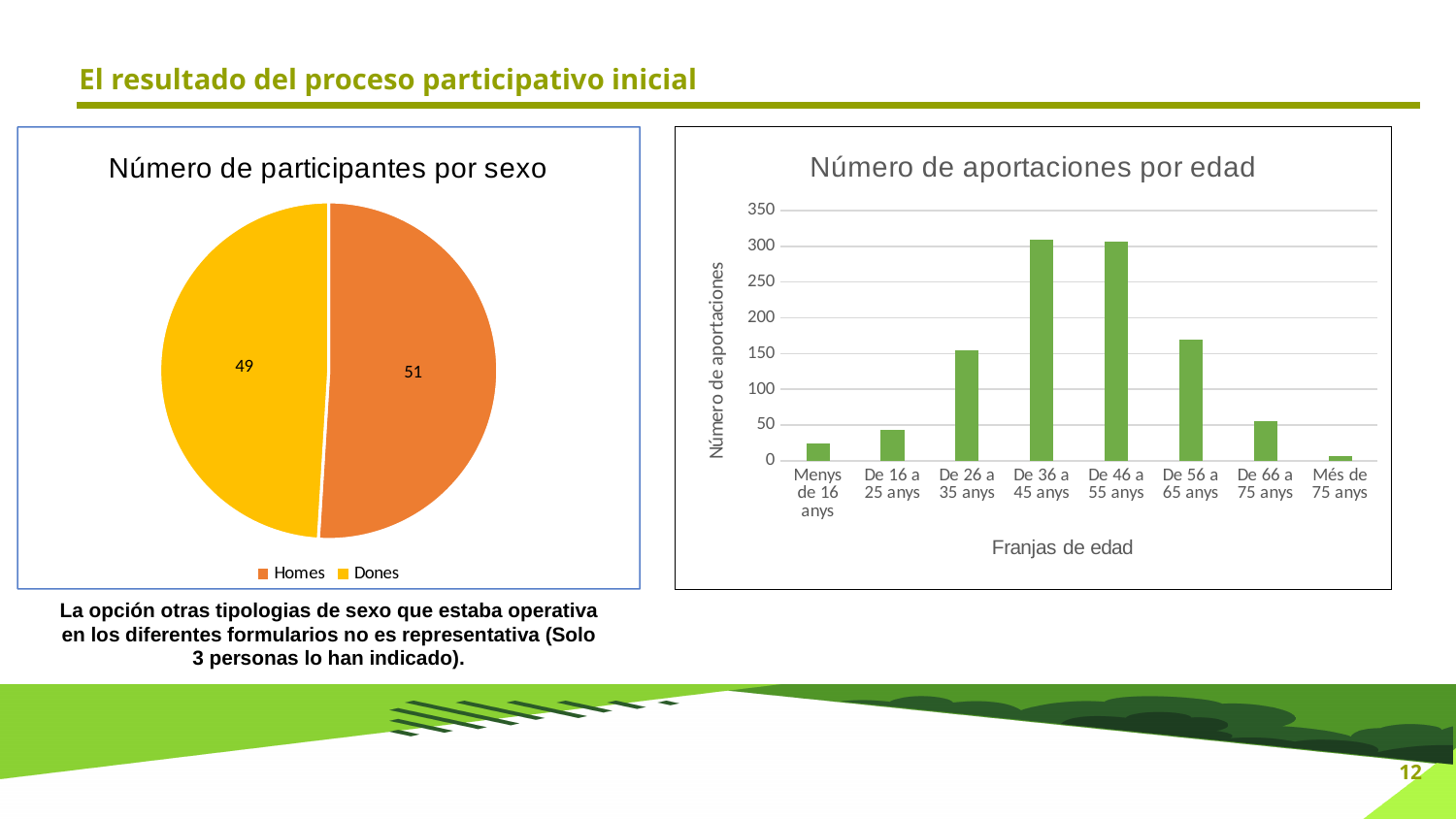
In the pie chart 'Número de participantes por sexo', what is the difference between the Homes and Dones values? 2 In the chart 'Número de aportaciones por edad', what is the label of the y axis? Número de aportaciones In the chart 'Número de aportaciones por edad', which age category has the lowest value? Més de 75 anys What type of chart is 'Número de aportaciones por edad'? Bar chart In the chart 'Número de aportaciones por edad', is the value for 'De 66 a 75 anys' greater or less than 100? less In the pie chart 'Número de participantes por sexo', what is the value for Homes? 51 In the pie chart 'Número de participantes por sexo', which category is larger, Homes or Dones? Homes In the chart 'Número de aportaciones por edad', how many age categories are shown on the x axis? 8 In the chart 'Número de aportaciones por edad', is the value for 'De 56 a 65 anys' greater or less than 150? greater In the pie chart 'Número de participantes por sexo', how many entries does the legend list? 2 In the pie chart 'Número de participantes por sexo', what share of the total does Homes represent? 51% In the pie chart 'Número de participantes por sexo', what is the value for Dones? 49